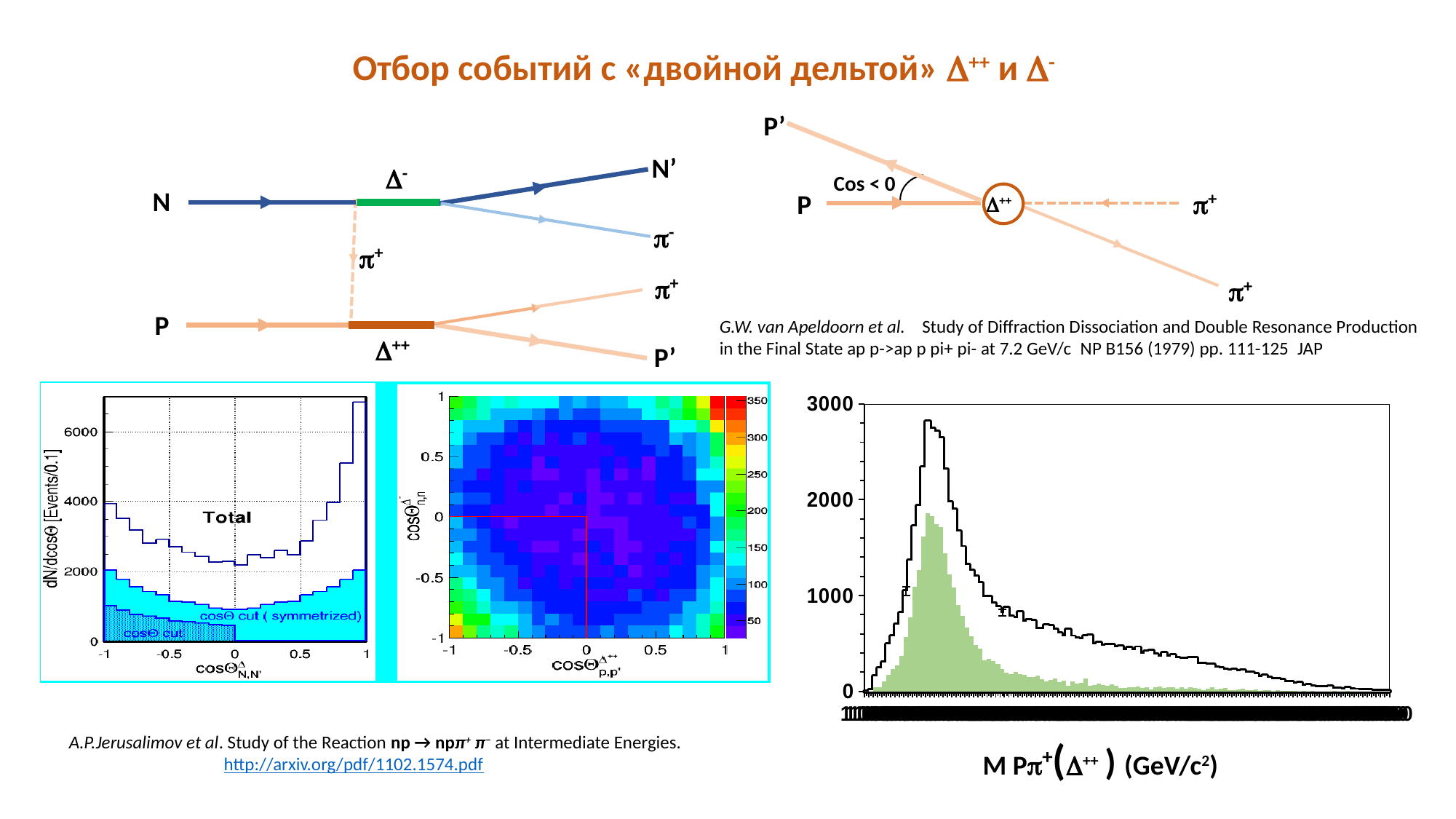
On the bottom-left chart, is the value of the Total histogram in the bin nearest cosΘ = 1 greater or less than 6000? greater On the middle chart, what is the highest value printed on the colour scale? 350 On the bottom-left chart, is the value of the Total histogram at cosΘ = 0 greater or less than 4000? less On the bottom-left chart, what is the highest value printed on the y axis? 6000 On the right chart, is the peak of the black open histogram greater or less than 3000? less On the bottom-left chart, which histogram has the larger value at cosΘ = 0: Total or cosΘ cut? Total On the bottom-left chart, what is the label of the y axis? dN/dcosΘ [Events/0.1] On the middle chart, what is the lowest value printed on the colour scale? 50 On the bottom-left chart, how many histograms are labelled? 3